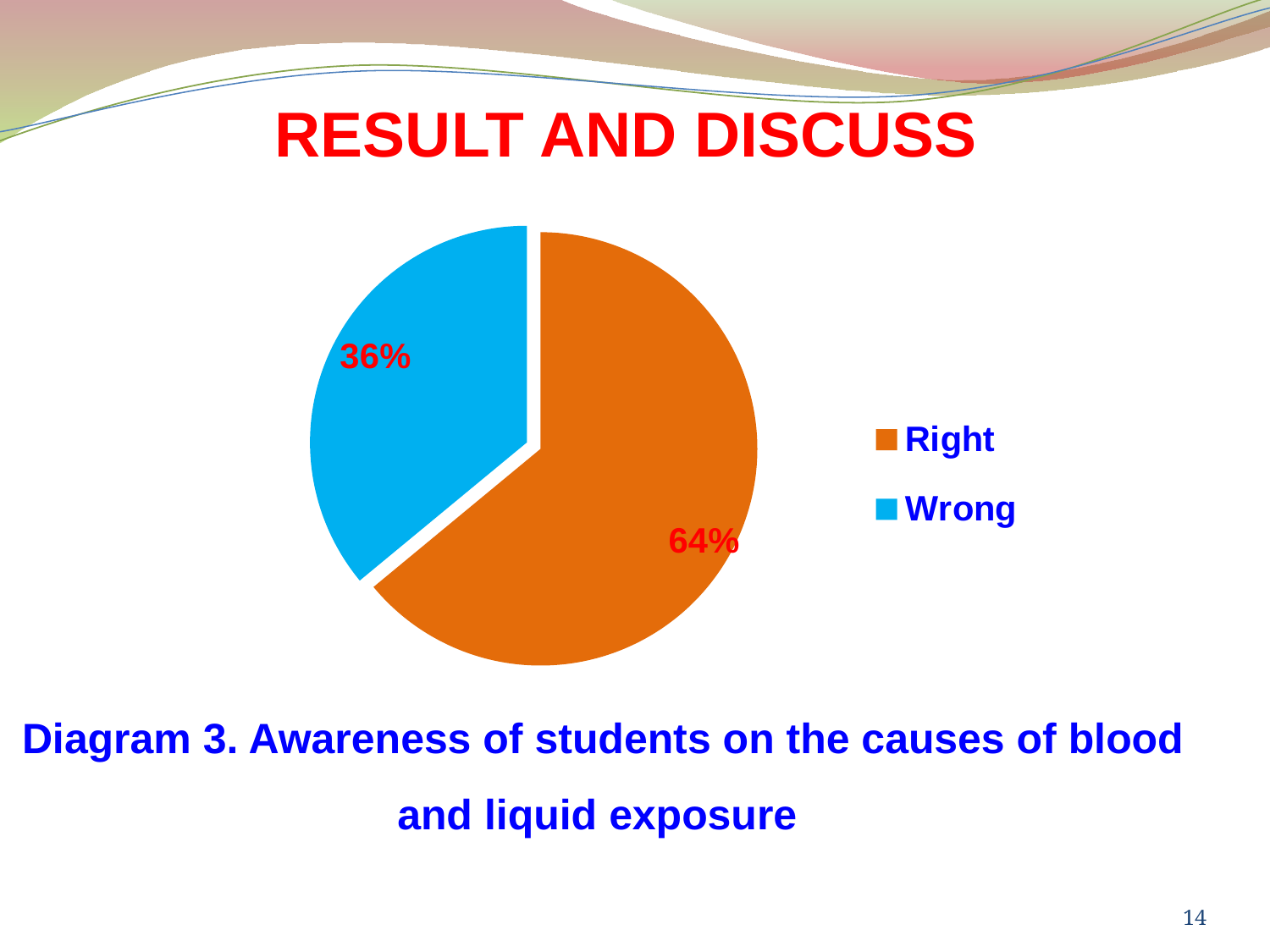
What share of the pie does the Wrong slice represent? 36% How many slices does the pie chart have? 2 Which slice is the smallest? Wrong What colour is the Right slice? orange Which slice is the largest? Right What percentage of the pie is labelled "Right"? 64% How many entries does the legend list? 2 Which is larger, the Right slice or the Wrong slice? Right What kind of chart is shown on the slide? pie chart What percentage of the pie is labelled "Wrong"? 36% What is the caption of the diagram below the chart? Diagram 3. Awareness of students on the causes of blood and liquid exposure What is the difference in percentage points between the Right and Wrong slices? 28